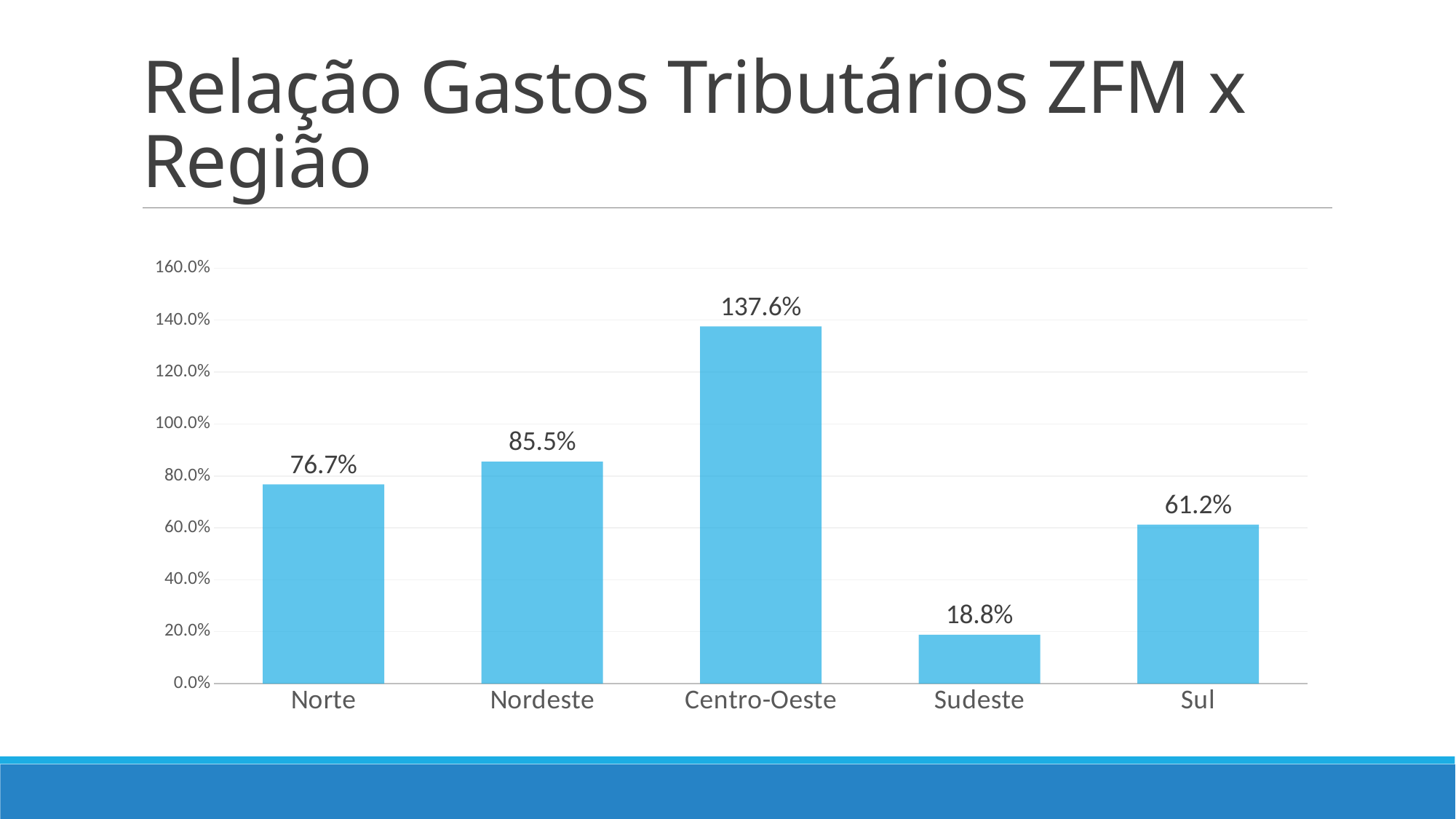
What is the value for Centro-Oeste? 137.6% Which is larger, the value for Norte or the value for Sul? Norte Is the value for Centro-Oeste greater or less than 100.0%? greater What is the value for Sudeste? 18.8% Which region has the lowest value? Sudeste What is the value for Sul? 61.2% What is the difference between the values for Nordeste and Norte? 8.8% Which region has the highest value? Centro-Oeste What kind of chart is shown on the slide? Bar chart How many regions are shown on the chart? 5 What is the difference between the values for Centro-Oeste and Sudeste? 118.8% What is the title of the slide? Relação Gastos Tributários ZFM x Região